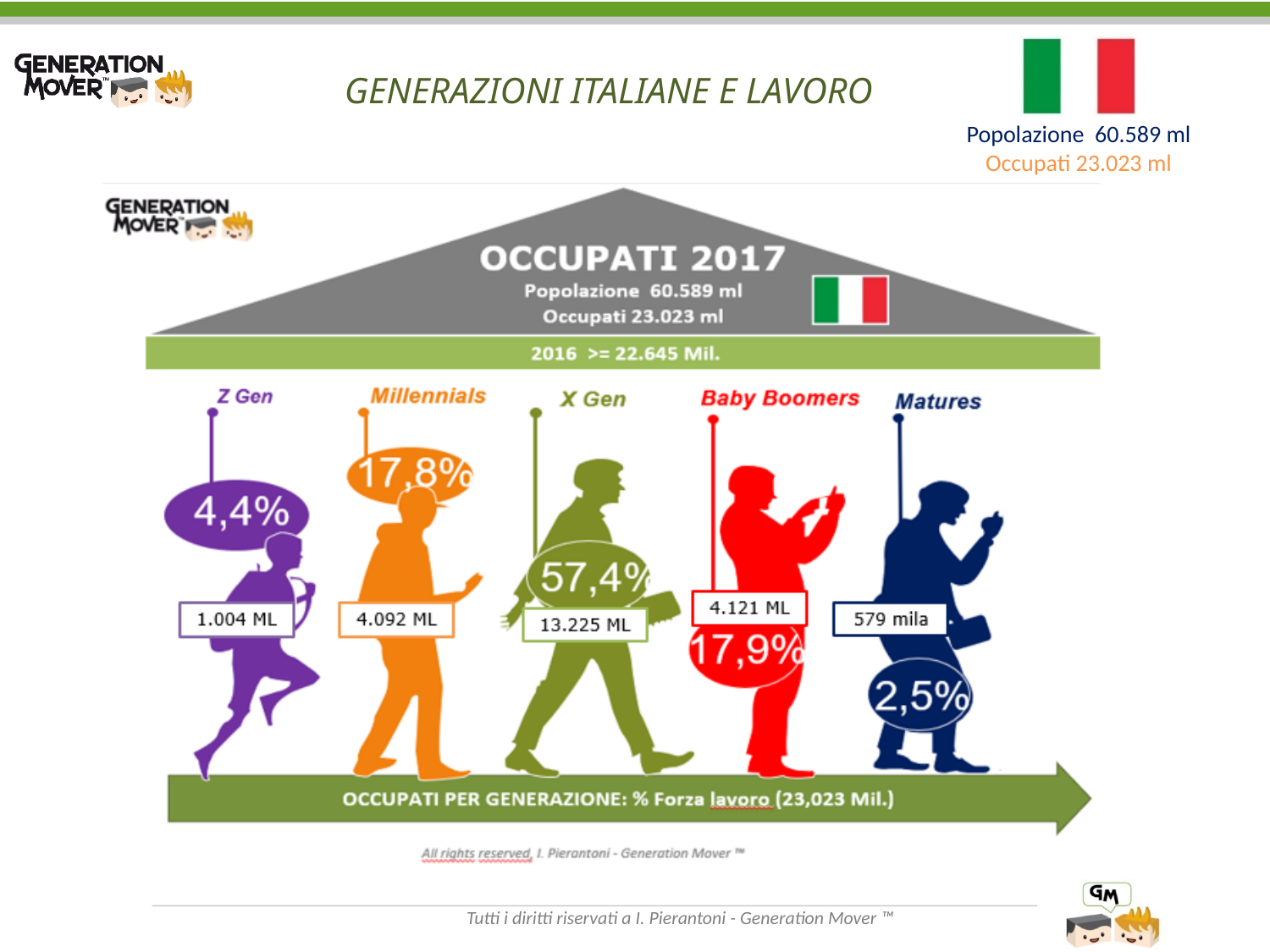
What is the difference in employed people between X Gen (13.225 ML) and Z Gen (1.004 ML)? 12.221 ML How many employed people are shown for Matures? 579 mila Which generation has the lowest share of the workforce? Matures Which generation has the highest share of the workforce? X Gen How many employed people (in ML) are shown for Millennials? 4.092 ML What percentage of the workforce is shown for Z Gen? 4,4% Which has a larger share of the workforce, Millennials or Z Gen? Millennials What total number of employed people (Occupati) is stated for 2017? 23.023 ml How many employed people are shown for Baby Boomers? 4.121 ML How many generations are shown in the infographic? 5 What percentage of the workforce is shown for Matures? 2,5% What percentage of the workforce is shown for X Gen? 57,4%